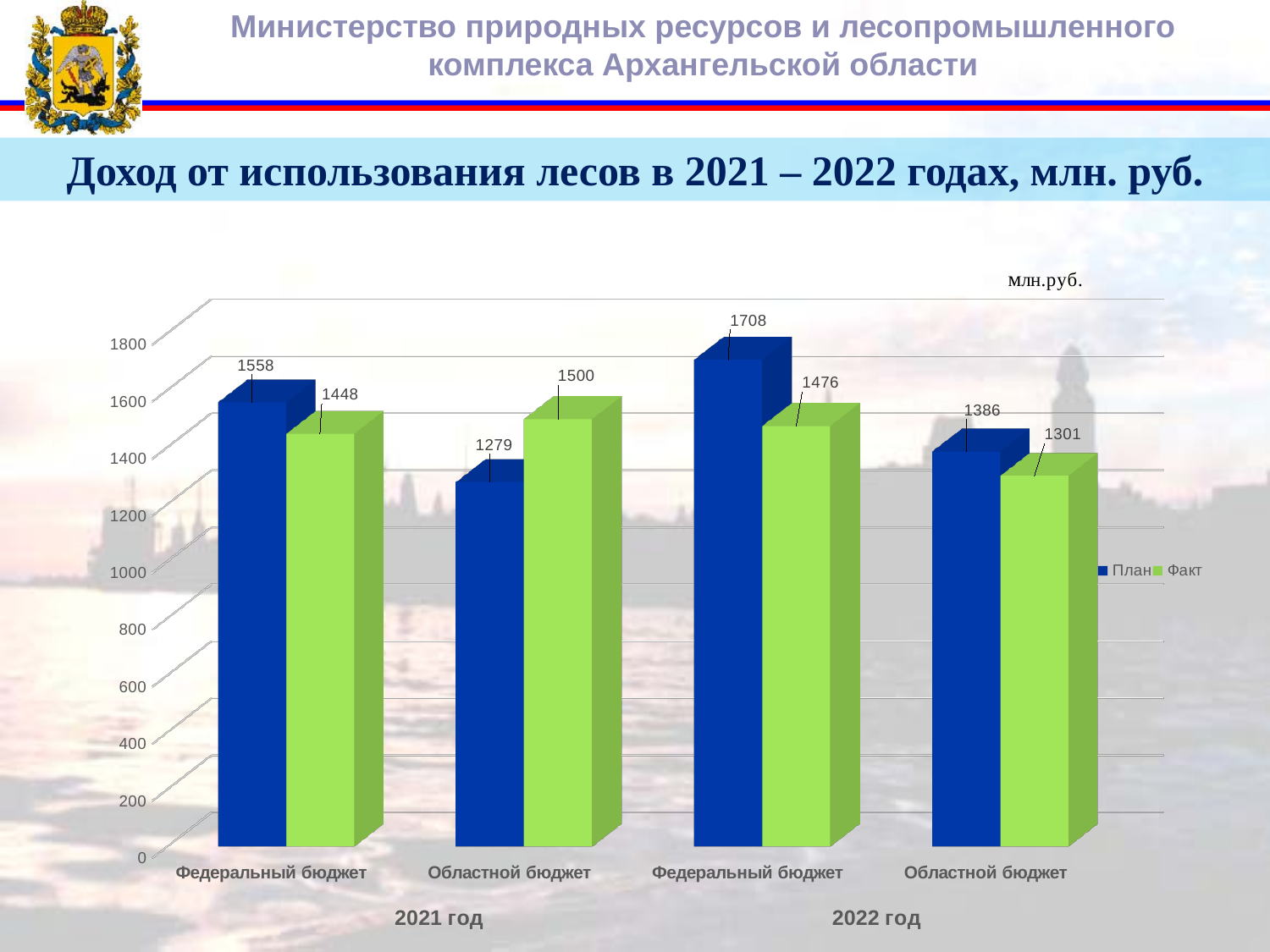
Which category has the highest План value? Федеральный бюджет, 2022 год What is the План value for Федеральный бюджет in 2021 год? 1558 What is the difference between the План and Факт values for Федеральный бюджет in 2022 год? 232 For Областной бюджет in 2021 год, which is larger, План or Факт? Факт What is the План value for Федеральный бюджет in 2022 год? 1708 Which category has the lowest Факт value? Областной бюджет, 2022 год Is the План value for Областной бюджет in 2021 год greater or less than 1400? less What is the Факт value for Областной бюджет in 2022 год? 1301 What is the Факт value for Областной бюджет in 2021 год? 1500 What is the title of the chart on the slide? Доход от использования лесов в 2021 – 2022 годах, млн. руб. How many series does the legend list? 2 What kind of chart is shown on the slide? Bar chart